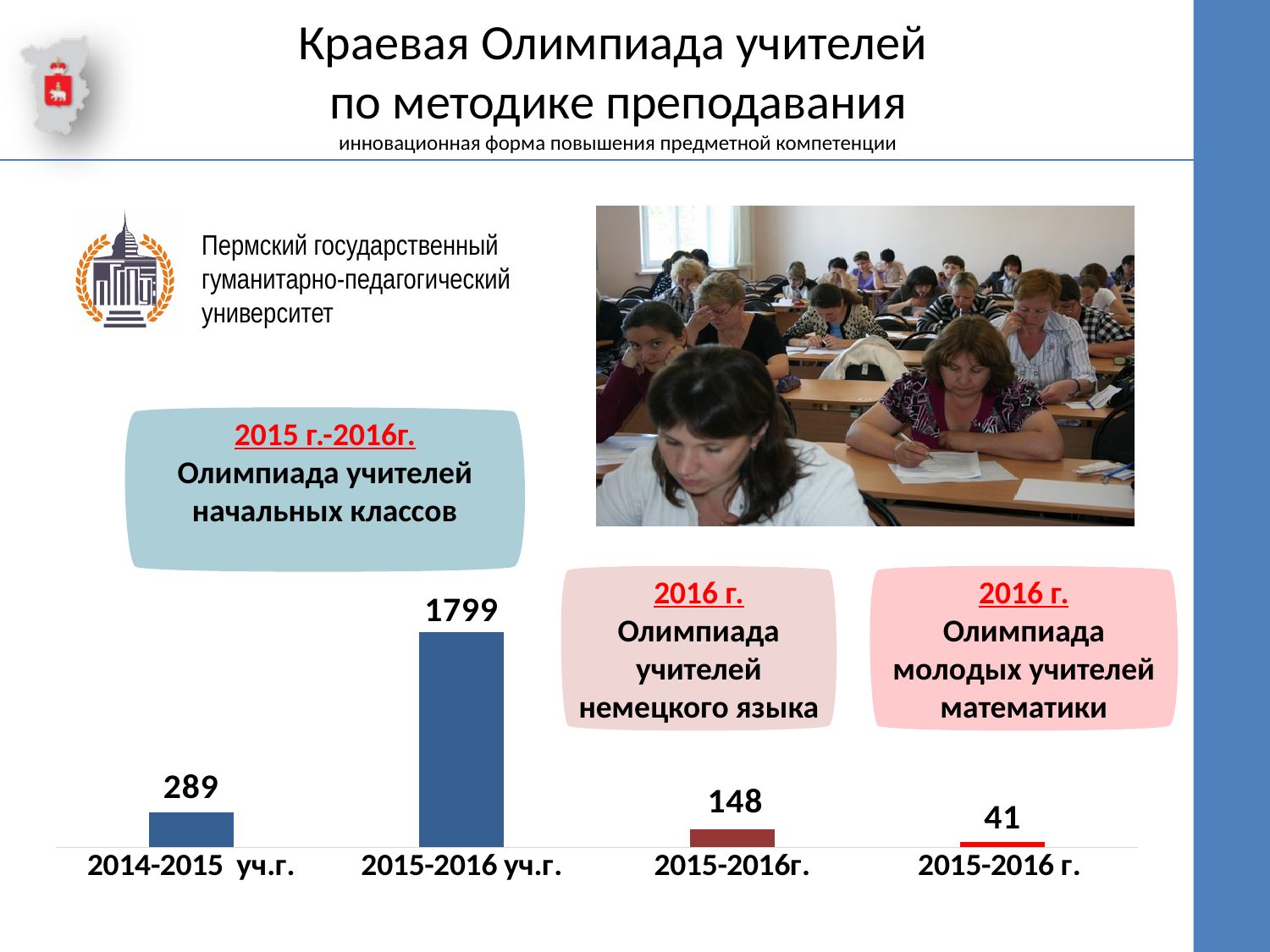
How many bars are plotted on the chart? 4 What value is shown for the 2014-2015 уч.г. bar? 289 Which is larger: the value for 2014-2015 уч.г. or the value on the third bar (German language teachers)? 2014-2015 уч.г. What value is shown for the 2015-2016 уч.г. bar (the tallest blue bar)? 1799 What colour are the two leftmost bars on the chart? Blue What value is shown on the rightmost bar, under the 'Олимпиада молодых учителей математики' callout? 41 What is the difference between the third bar (148) and the rightmost bar (41)? 107 What is the difference between the 2015-2016 уч.г. bar (1799) and the 2014-2015 уч.г. bar (289)? 1510 What is the lowest value shown on the chart? 41 Which bar has the highest value? 2015-2016 уч.г. What type of chart is shown on the slide? Bar chart What value is shown on the third bar from the left, the dark red bar under the 'Олимпиада учителей немецкого языка' callout? 148